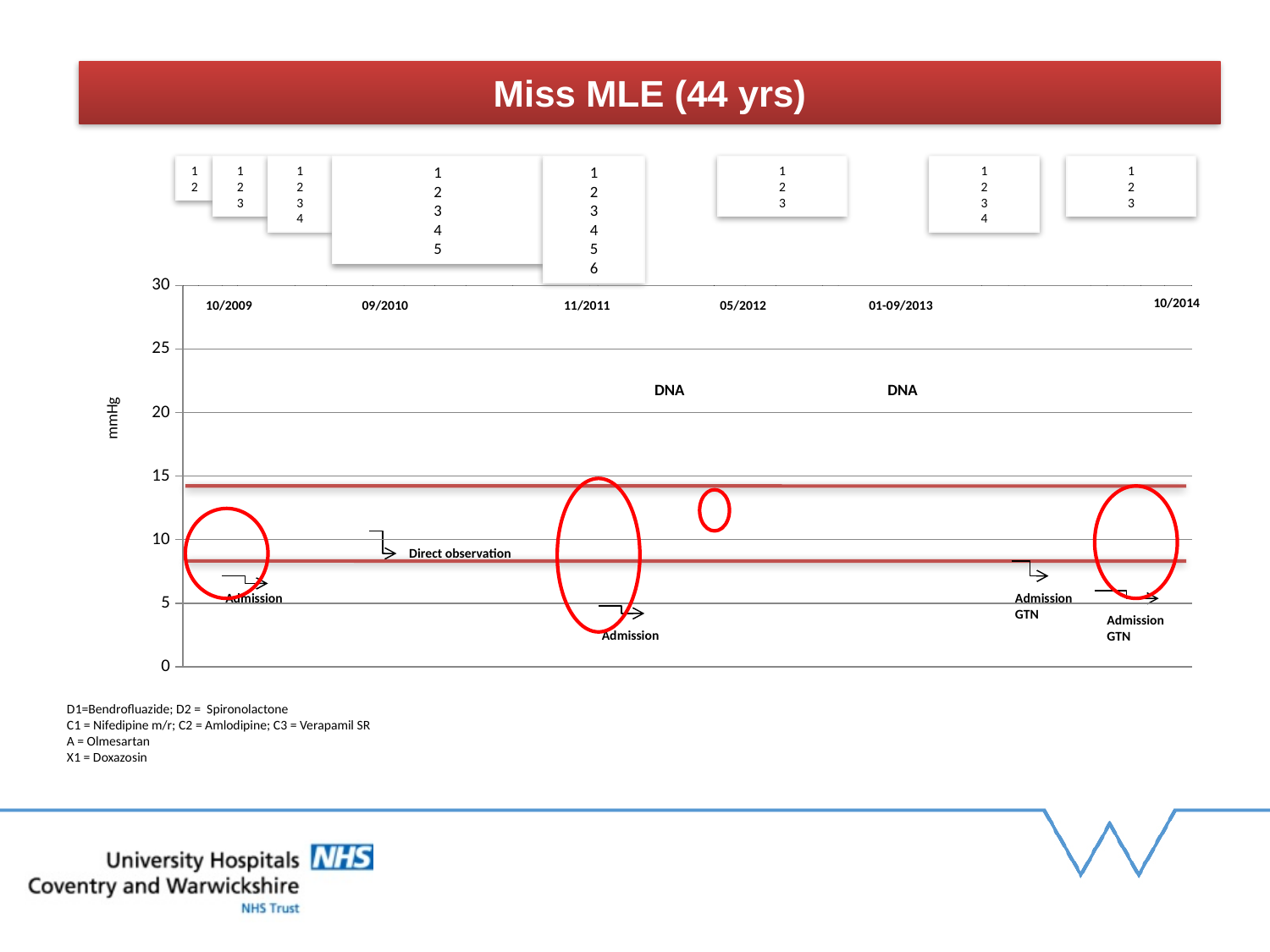
What unit is shown on the y-axis label of the chart? mmHg How many date labels are shown along the top of the chart's plot area? 6 Which of the two red horizontal lines on the chart is higher, the one near 14 or the one near 8? the one near 14 What is the last date label shown on the chart? 10/2014 What is the title of the slide containing the chart? Miss MLE (44 yrs) Is the upper red horizontal line on the chart greater or less than 15 mmHg? less Is the lower red horizontal line on the chart greater or less than 5 mmHg? greater What is the maximum value shown on the chart's y-axis? 30 Is the lower red horizontal line on the chart greater or less than 10 mmHg? less Which date label on the chart is annotated with "Direct observation"? 09/2010 How many times does the annotation "DNA" appear on the chart? 2